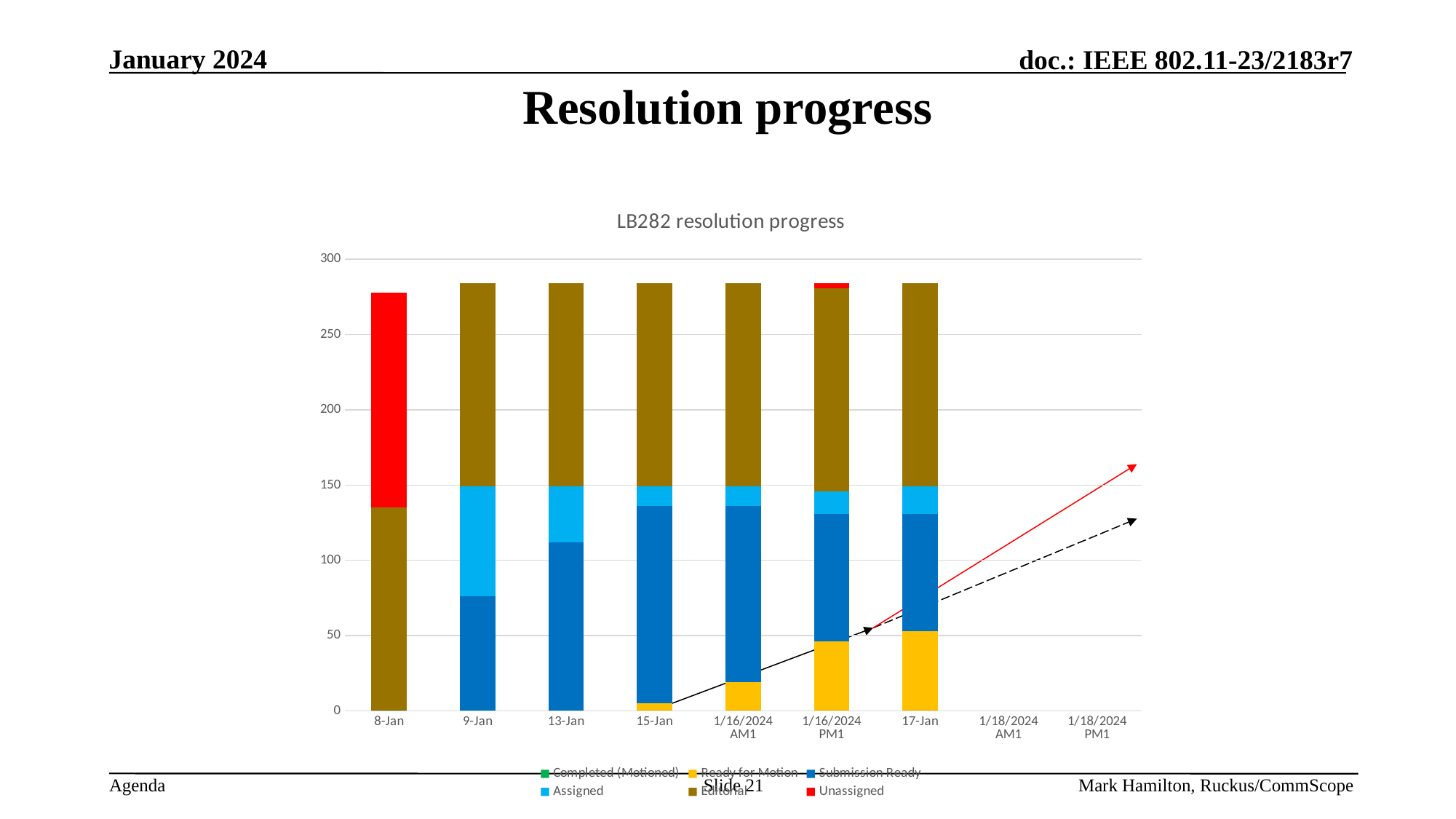
Does the Ready for Motion segment rise or fall from 15-Jan to 17-Jan? rise Which date has the largest Unassigned segment? 8-Jan Which date has the largest Assigned segment? 9-Jan What is the title of the chart? LB282 resolution progress How many category labels are shown along the x axis? 9 Is the total height of the 8-Jan bar greater or less than 250? greater What kind of chart is shown on the slide? Stacked bar chart Is the Ready for Motion segment for 1/16/2024 AM1 greater or less than 50? less How many of the x-axis categories have a bar plotted? 7 Is the Submission Ready segment for 9-Jan greater or less than 100? less How many series does the chart legend list? 6